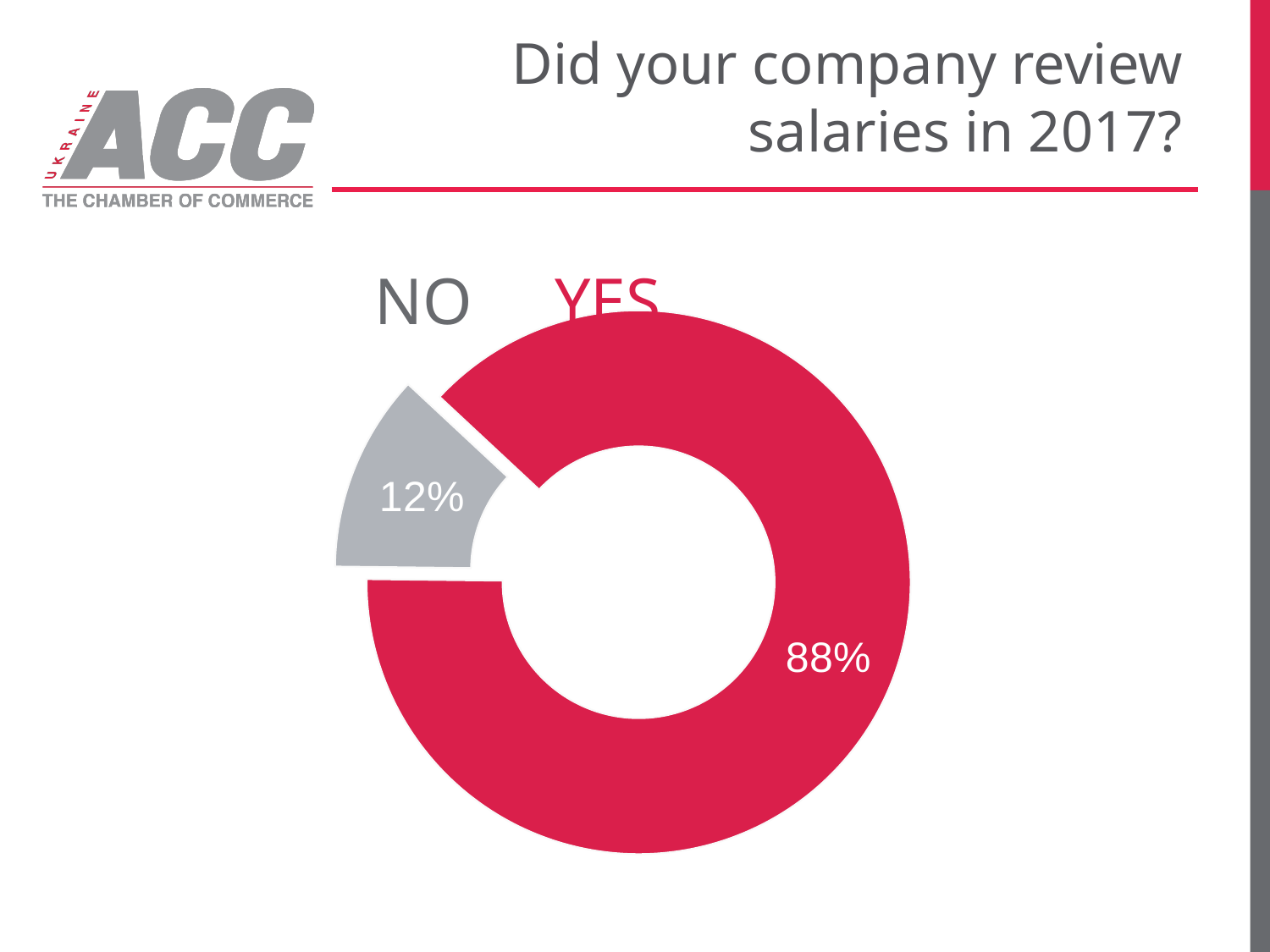
Which response has the largest share of the chart? YES What percentage of companies answered YES to reviewing salaries in 2017? 88% Which response has the smallest share of the chart? NO What kind of chart is shown on the slide? Doughnut (pie) chart What is the title of the slide's chart question? Did your company review salaries in 2017? What colour is the YES segment of the chart? Red What percentage of companies answered NO to reviewing salaries in 2017? 12% Which is larger, the YES share or the NO share? YES How many categories are shown in the chart? 2 What share of the chart does the NO slice represent? 12% What is the difference in percentage points between the YES and NO shares? 76